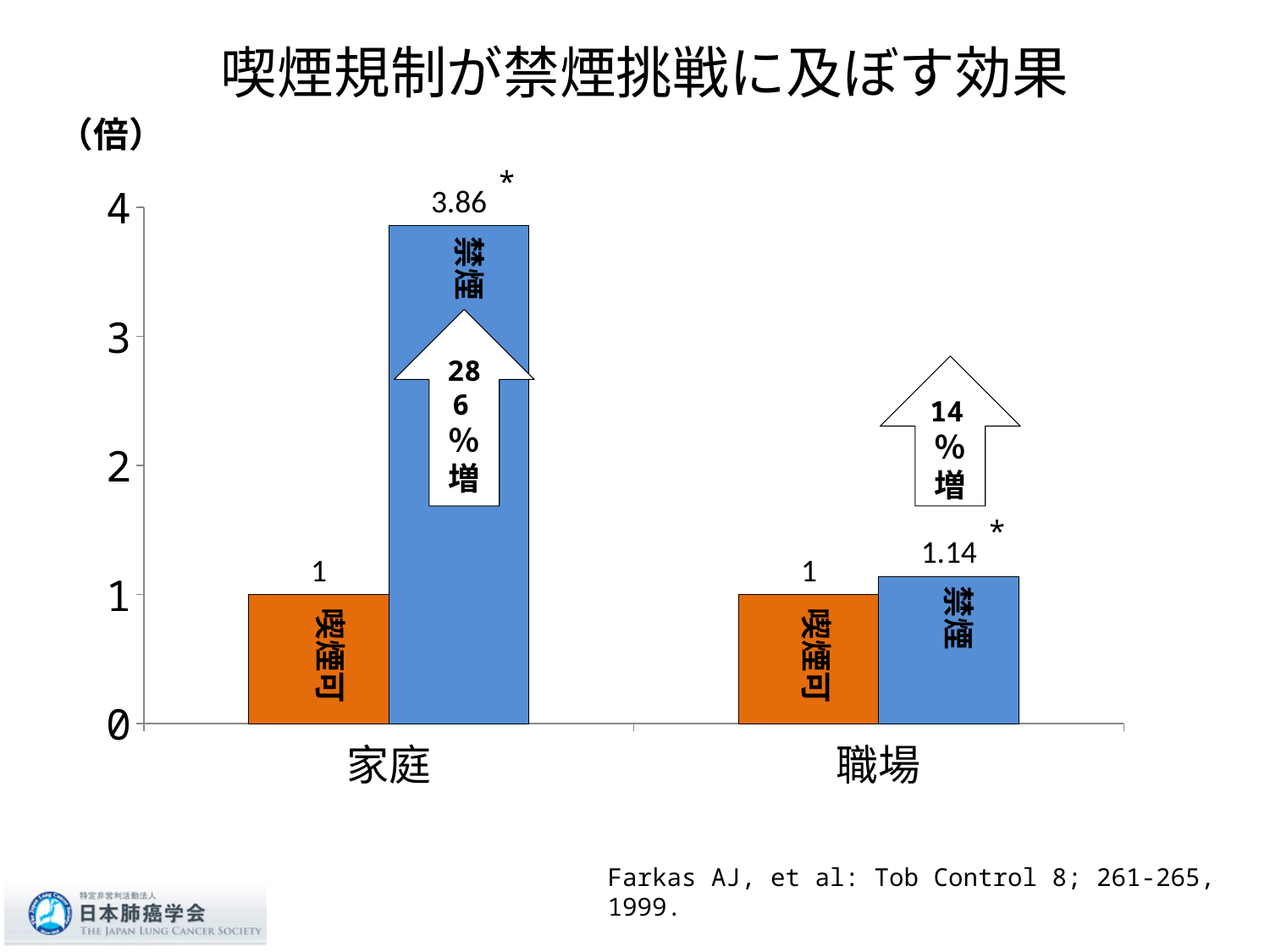
What is the difference between the 禁煙 and 喫煙可 values in the 家庭 category? 2.86 Is the 禁煙 value for 家庭 greater or less than 3? greater What is the difference between the 禁煙 and 喫煙可 values in the 職場 category? 0.14 How many categories are shown on the x axis? 2 What is the title of the chart? 喫煙規制が禁煙挑戦に及ぼす効果 What percentage increase is shown by the arrow in the 職場 category? 14%増 What kind of chart is shown on the slide? Bar chart What is the value for 禁煙 in the 家庭 category? 3.86 What is the value for 喫煙可 in the 家庭 category? 1 Which bar has the highest value on the chart? 禁煙 in 家庭 (3.86) What is the value for 禁煙 in the 職場 category? 1.14 Which is larger: the 禁煙 value for 家庭 or the 禁煙 value for 職場? 家庭